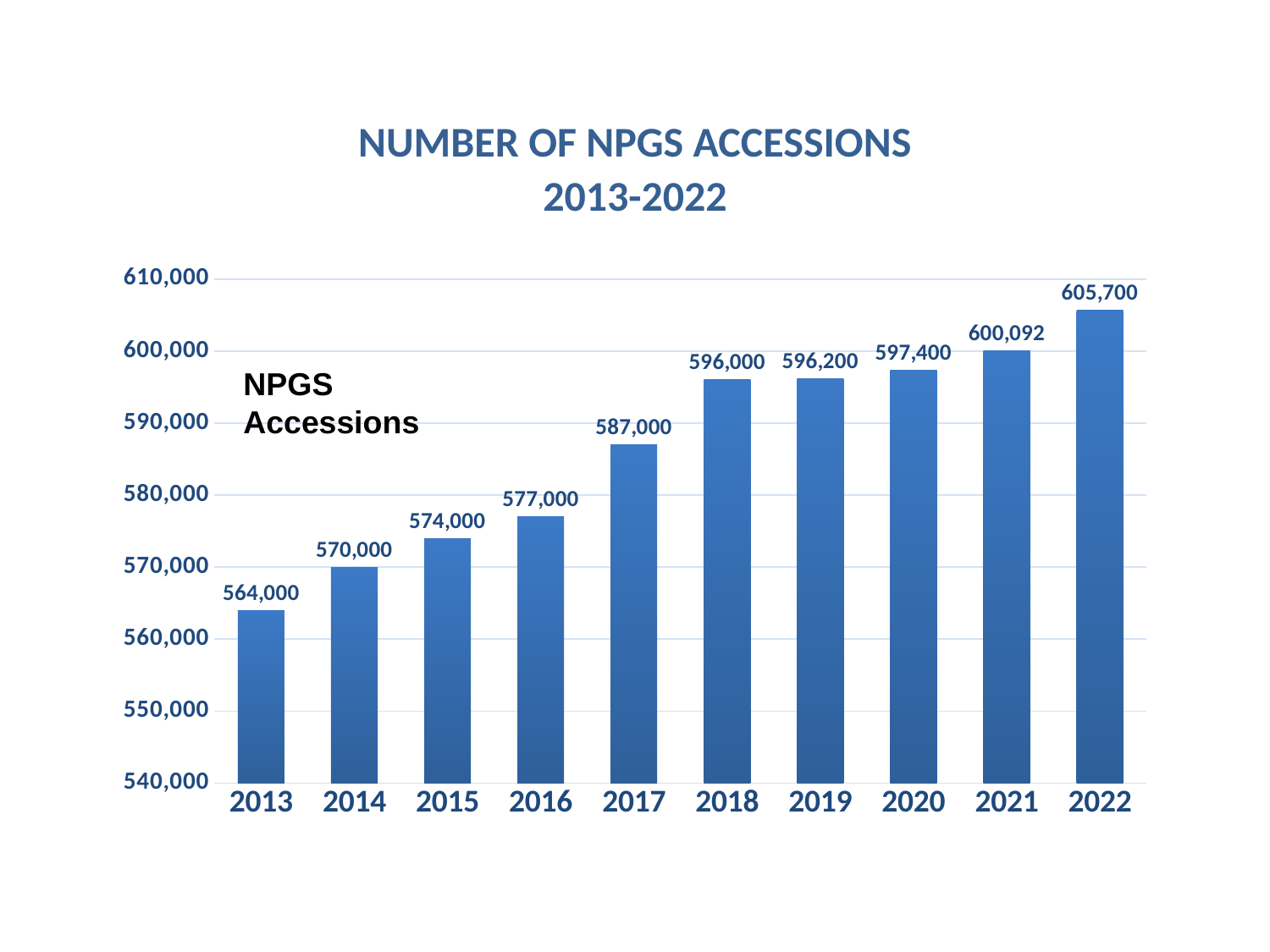
Which year has the highest number of NPGS accessions? 2022 How many years are shown on the chart? 10 Is the value for 2020 greater or less than 600,000? less Which year has more NPGS accessions, 2016 or 2019? 2019 What is the difference in NPGS accessions between 2018 and 2017? 9,000 What is the number of NPGS accessions in 2017? 587,000 What kind of chart is shown on the slide? bar chart Which year has the lowest number of NPGS accessions? 2013 What is the number of NPGS accessions in 2013? 564,000 What is the difference in NPGS accessions between 2022 and 2013? 41,700 Do the values rise or fall from 2013 to 2022? rise What is the number of NPGS accessions in 2021? 600,092